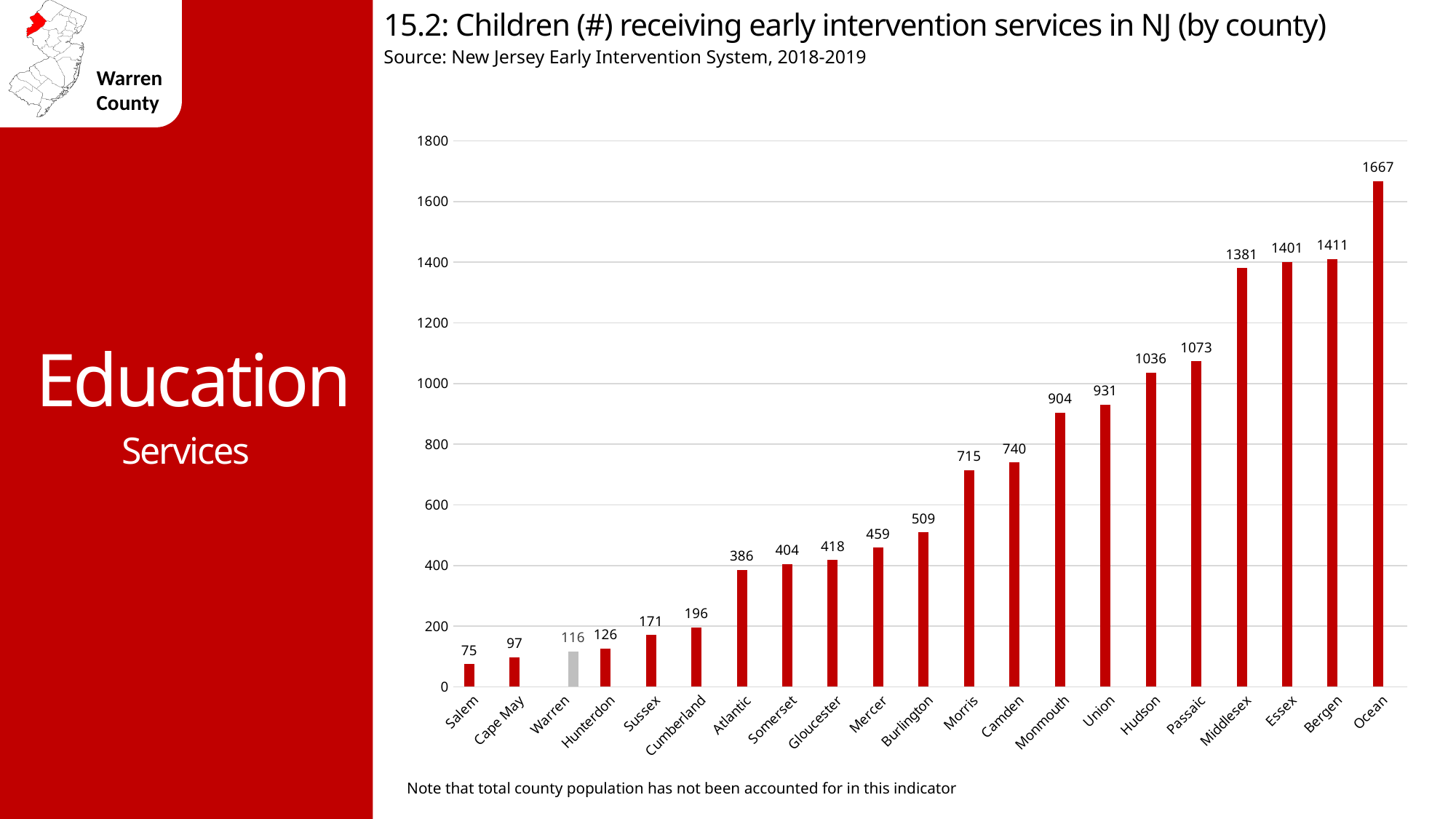
What is the difference between the values for Ocean and Bergen? 256 Which county's bar is shown in grey rather than red? Warren What is the value shown for Ocean County? 1667 How many children received early intervention services in Warren County? 116 What is the value shown for Mercer County? 459 Which county has a larger value, Morris or Camden? Camden What is the difference between the values for Warren and Salem? 41 Which county has the lowest number of children receiving early intervention services? Salem How many counties are shown on the chart? 21 What kind of chart is shown on the slide? Bar chart Is the value for Hudson greater or less than 1000? greater Which county has the highest number of children receiving early intervention services? Ocean